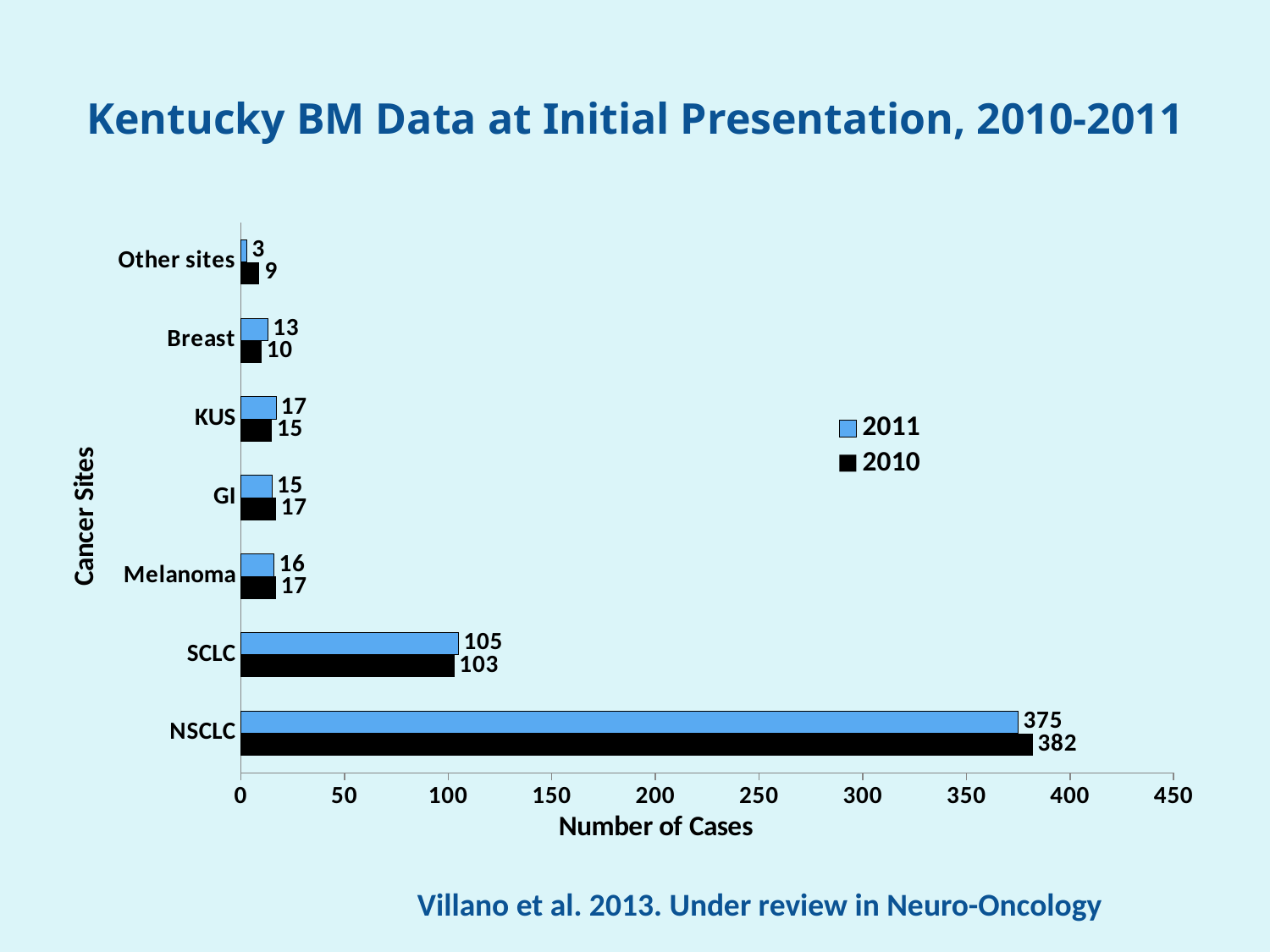
How many cancer sites are shown on the chart? 7 What is the number of cases for Breast in 2011? 13 What is the difference between the 2010 and 2011 number of cases for NSCLC? 7 Which is larger for Other sites, the 2010 value or the 2011 value? 2010 What is the number of cases for NSCLC in 2011? 375 Which cancer site has the highest number of cases in 2010? NSCLC How many series does the legend list? 2 Which cancer site has the lowest number of cases in 2011? Other sites What kind of chart is shown on the slide? Bar chart What is the number of cases for SCLC in 2010? 103 Is the value for SCLC in 2011 greater or less than 100? greater What is the label of the x axis? Number of Cases